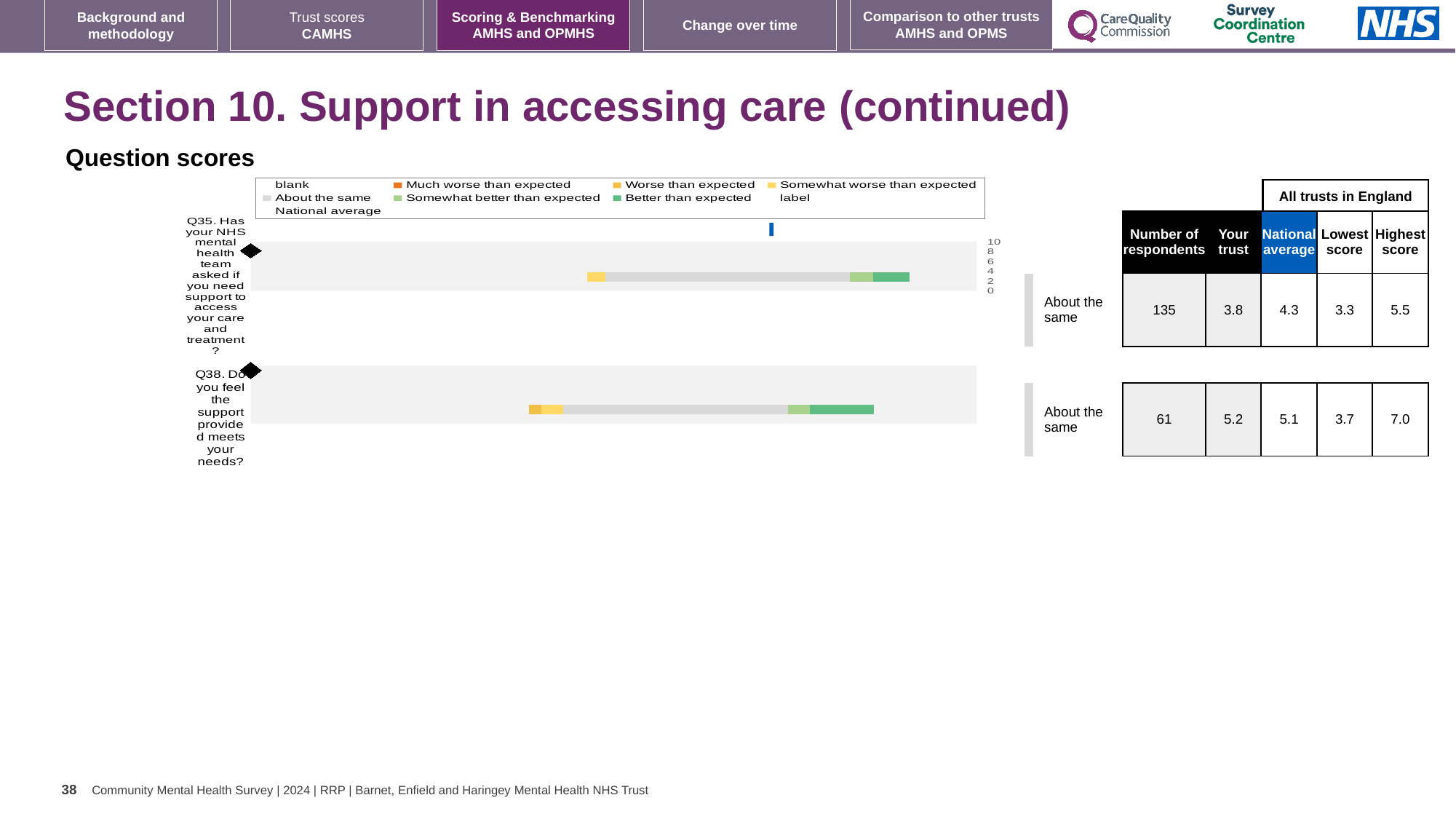
Which question has more respondents, Q35 or Q38? Q35 What is the 'Your trust' score for Q35 in the table next to the chart? 3.8 Which legend entry is shown in dark green? Better than expected What is the difference in number of respondents between Q35 and Q38? 74 What is the difference between the highest score and the lowest score for Q38? 3.3 What is the national average for Q35? 4.3 How many questions (bars) are plotted in the chart? 2 What benchmark category is given for Q35? About the same What kind of chart is shown under 'Question scores'? bar chart What is the 'Your trust' score for Q38 in the table next to the chart? 5.2 What is the highest value shown on the chart's axis? 10 How many respondents answered Q38? 61